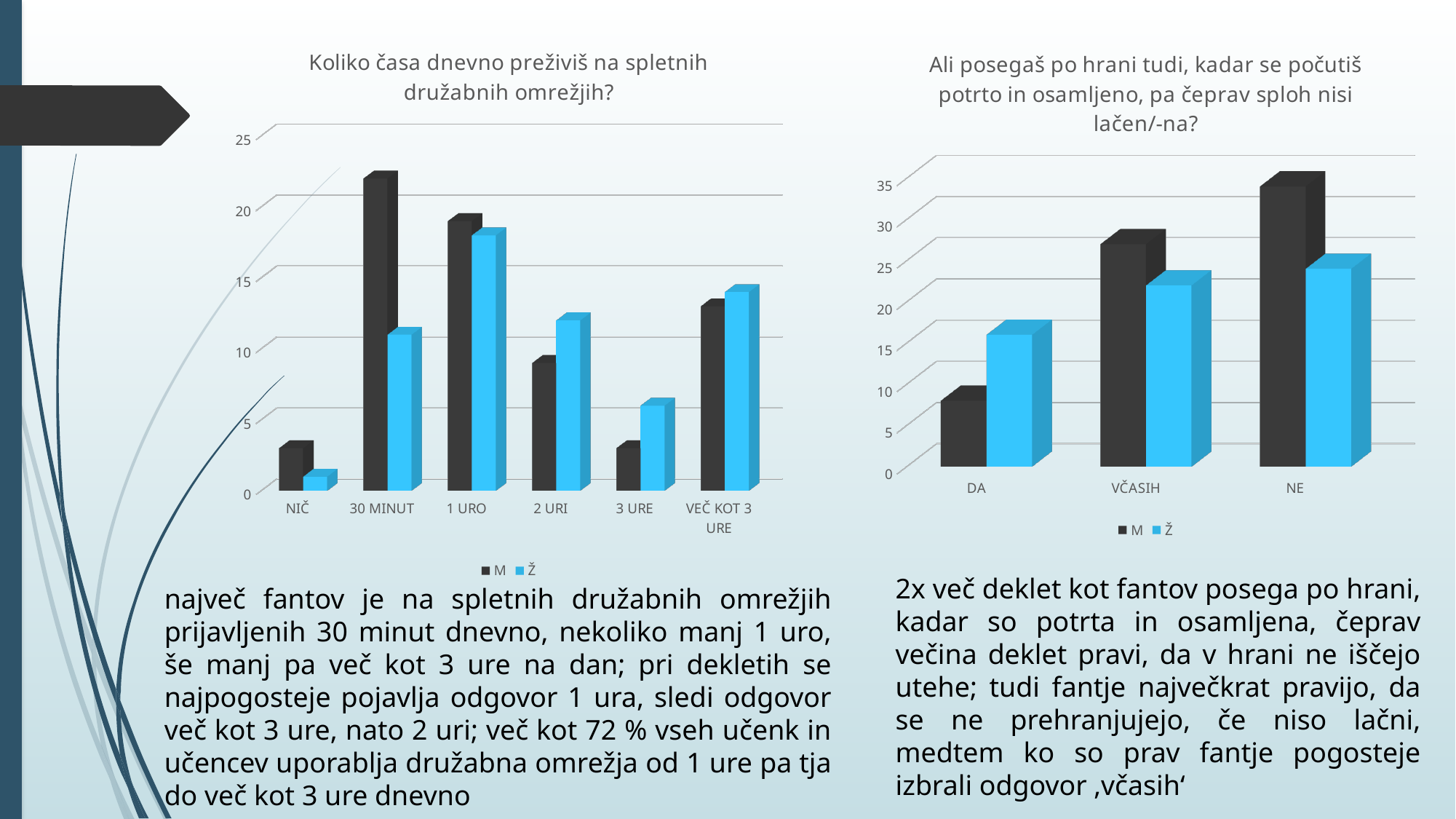
What kind of chart is the chart on the right side of the slide? bar chart In the chart 'Koliko časa dnevno preživiš na spletnih družabnih omrežjih?', is the Ž value for 30 MINUT greater or less than 15? less In the chart 'Koliko časa dnevno preživiš na spletnih družabnih omrežjih?', which series has the larger value for 2 URI, M or Ž? Ž In the chart 'Koliko časa dnevno preživiš na spletnih družabnih omrežjih?', which category has the highest value for the Ž series? 1 URO In the chart 'Ali posegaš po hrani tudi, kadar se počutiš potrto in osamljeno...', which category has the lowest value for the Ž series? DA How many series does the legend of the chart 'Ali posegaš po hrani tudi, kadar se počutiš potrto in osamljeno...' list? 2 In the chart 'Ali posegaš po hrani tudi, kadar se počutiš potrto in osamljeno...', is the M value for DA greater or less than 10? less In the chart 'Koliko časa dnevno preživiš na spletnih družabnih omrežjih?', is the M value for 30 MINUT greater or less than 20? greater In the chart 'Ali posegaš po hrani tudi, kadar se počutiš potrto in osamljeno...', which category has the highest value for the M series? NE In the chart 'Koliko časa dnevno preživiš na spletnih družabnih omrežjih?', which category has the highest value for the M series? 30 MINUT In the chart 'Ali posegaš po hrani tudi, kadar se počutiš potrto in osamljeno...', which series has the larger value for DA, M or Ž? Ž How many categories are shown on the x axis of the chart 'Koliko časa dnevno preživiš na spletnih družabnih omrežjih?'? 6